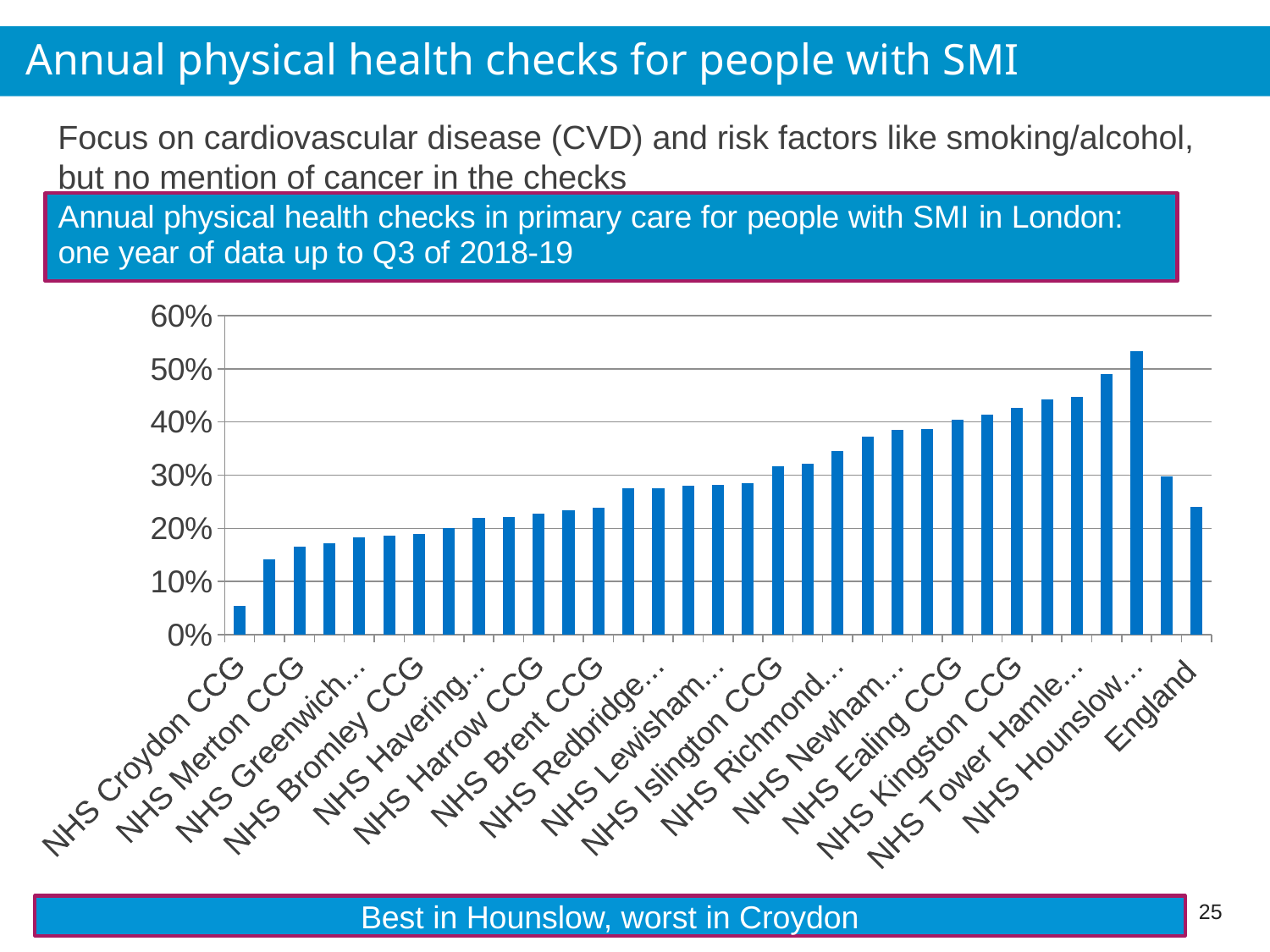
What kind of chart is shown on the slide? bar chart Which has a larger value, NHS Tower Hamlets CCG or NHS Brent CCG? NHS Tower Hamlets CCG Is the value for NHS Richmond CCG greater or less than 30%? greater Is the value for NHS Croydon CCG greater or less than 10%? less Which CCG has the highest value in the chart? NHS Hounslow CCG Do the values for the CCGs rise or fall from left to right across the chart? rise Is the value for NHS Kingston CCG greater or less than 40%? greater Which has a larger value, NHS Hounslow CCG or NHS Croydon CCG? NHS Hounslow CCG Which CCG has the lowest value in the chart? NHS Croydon CCG